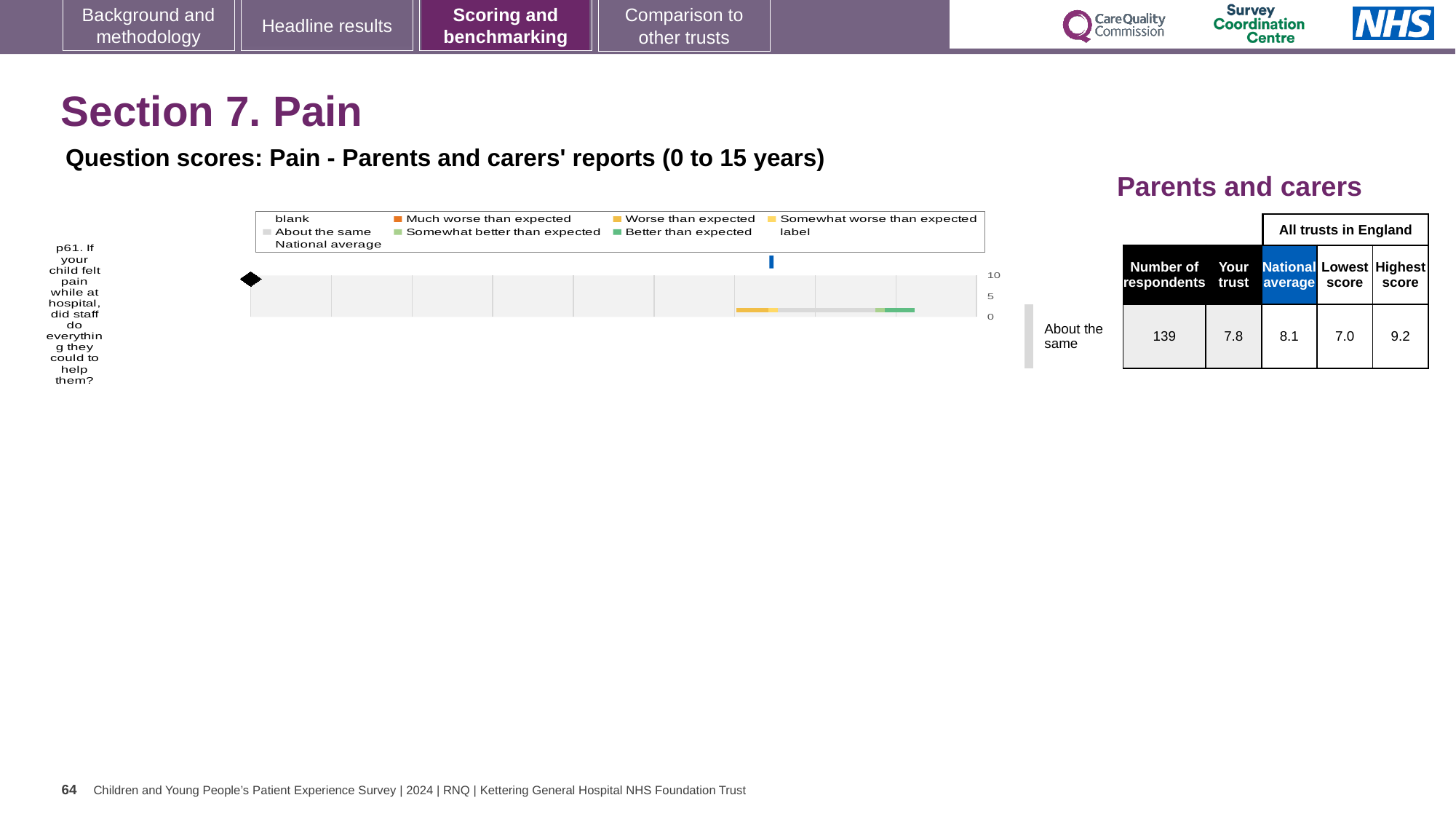
How many entries does the chart's legend list? 9 What colour does the legend use for 'Better than expected'? green What is the highest tick value shown on the chart's axis? 10 In the table beside the chart, what is the lowest score among all trusts in England for question p61? 7.0 In the table beside the chart, what is the difference between the highest score and the lowest score for question p61? 2.2 In the table beside the chart, what is the highest score among all trusts in England for question p61? 9.2 What kind of chart is shown on the slide? bar chart In the table beside the chart, what is the 'Your trust' score for question p61? 7.8 How many survey questions are plotted in the chart? 1 In the table beside the chart, what is the national average score for question p61? 8.1 In the table beside the chart, what is the number of respondents for question p61? 139 In the table beside the chart, which is larger for question p61: the 'Your trust' score or the national average? National average